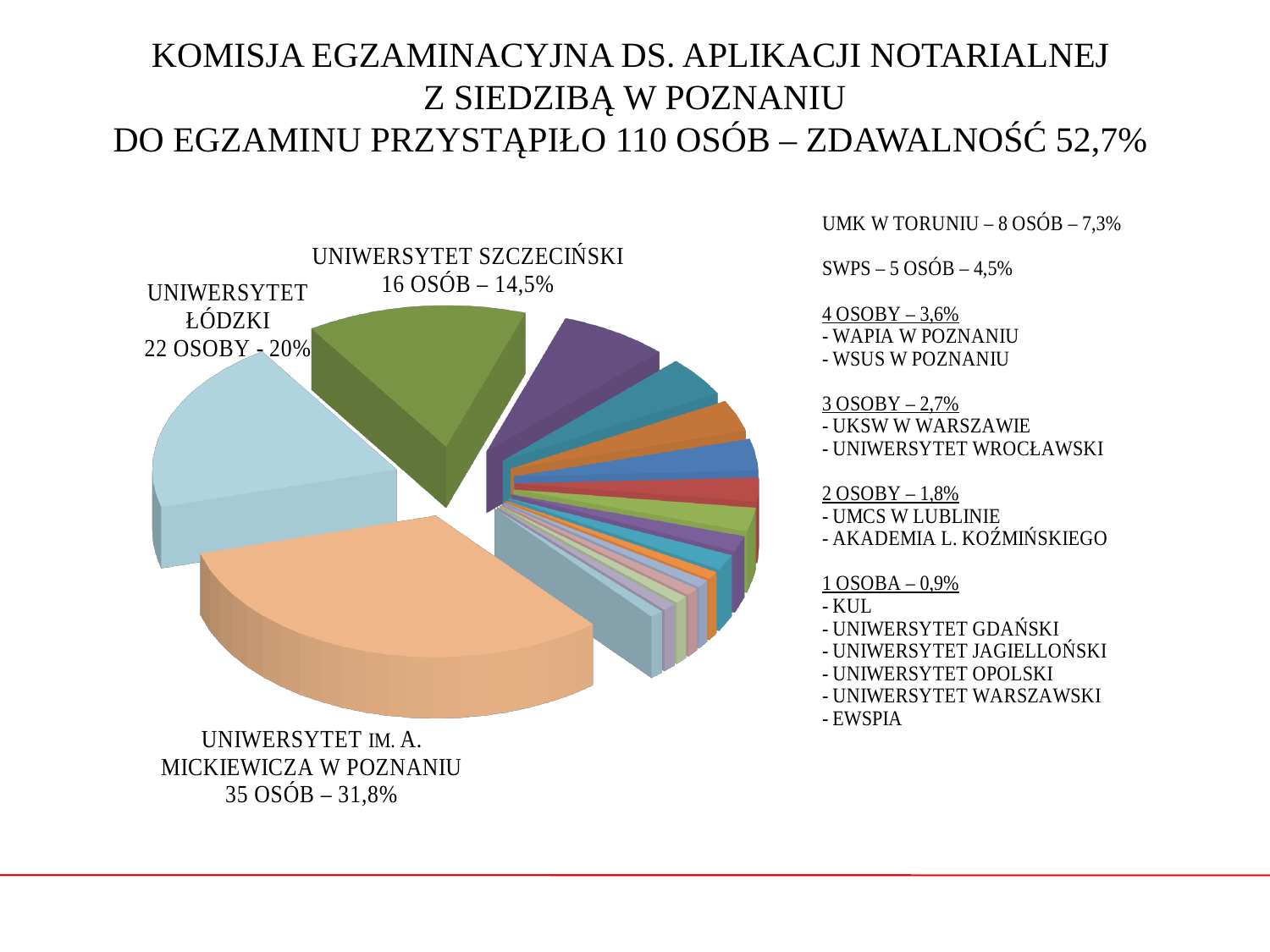
How many people in total took the exam according to the slide title? 110 osób What kind of chart is shown on the slide? pie chart Which has more people, Uniwersytet Szczeciński or UMK w Toruniu? Uniwersytet Szczeciński What percentage share does Uniwersytet Łódzki have in the pie chart? 20% What percentage share corresponds to 1 osoba? 0,9% What is the difference in number of people between Uniwersytet im. A. Mickiewicza w Poznaniu and Uniwersytet Łódzki? 13 How many people does SWPS account for? 5 osób How many people from Uniwersytet Szczeciński took the exam? 16 osób How many people from Uniwersytet im. A. Mickiewicza w Poznaniu took the exam? 35 osób Which university has the largest slice of the pie chart? Uniwersytet im. A. Mickiewicza w Poznaniu What percentage share does UMK w Toruniu have? 7,3% What is the pass rate (zdawalność) given in the slide title? 52,7%